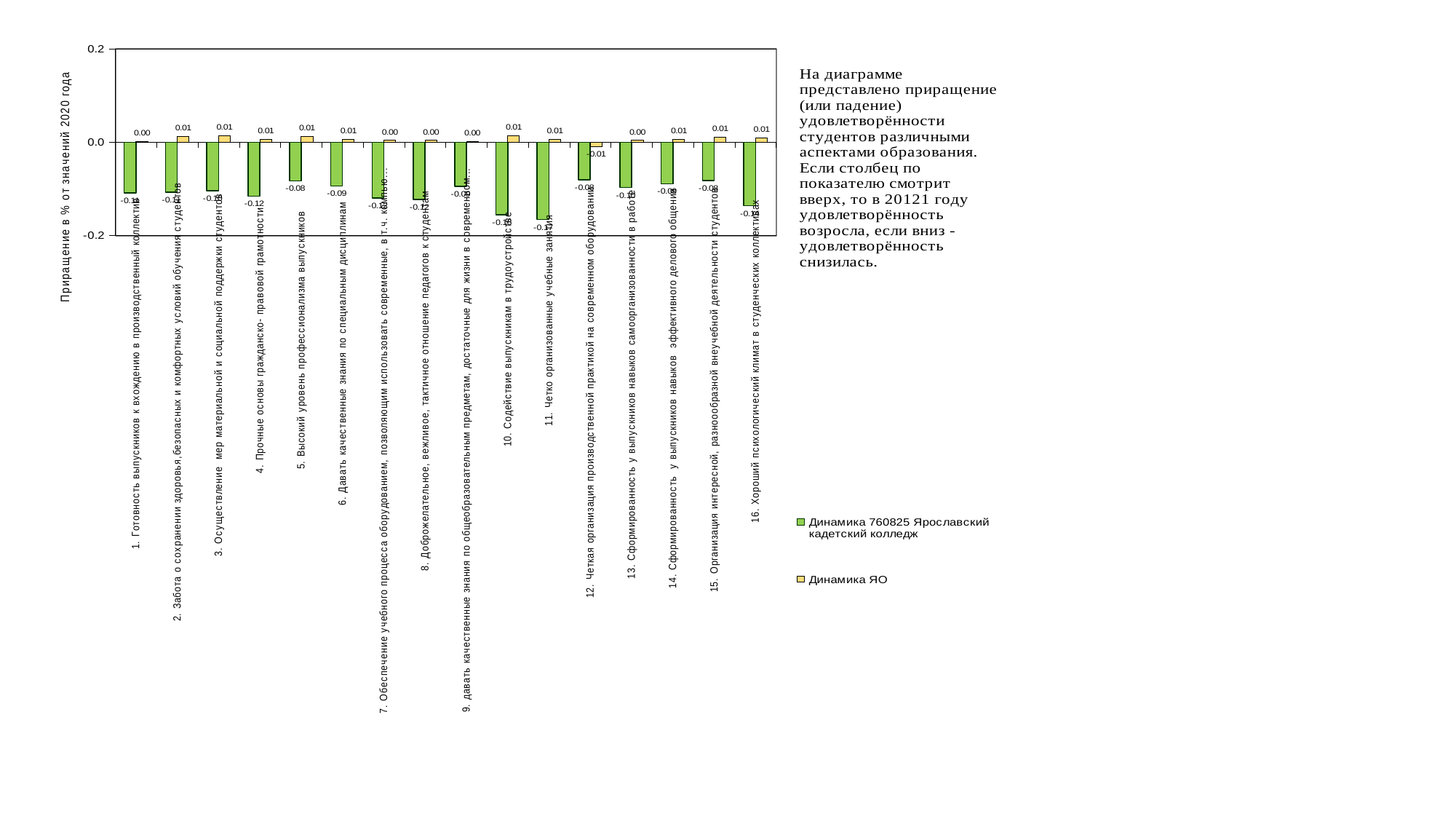
What is the value of the 'Динамика 760825 Ярославский кадетский колледж' series for category 5 (Высокий уровень профессионализма выпускников)? -0.08 What is the title of the vertical axis? Приращение в % от значений 2020 года What is the value of the 'Динамика ЯО' series for category 12 (Четкая организация производственной практикой на современном оборудовании)? -0.01 Which category has the lowest value for the 'Динамика ЯО' series? 12. Четкая организация производственной практикой на современном оборудовании What is the difference between the 'Динамика 760825 Ярославский кадетский колледж' values for category 5 and category 4? 0.04 What is the value of the 'Динамика 760825 Ярославский кадетский колледж' series for category 6 (Давать качественные знания по специальным дисциплинам)? -0.09 Which category has the lowest value for the 'Динамика 760825 Ярославский кадетский колледж' series? 11. Четко организованные учебные занятия How many categories are plotted along the x axis? 16 What is the value of the 'Динамика 760825 Ярославский кадетский колледж' series for category 4 (Прочные основы гражданско-правовой грамотности)? -0.12 For the 'Динамика 760825 Ярославский кадетский колледж' series, which is larger: the value for category 5 or the value for category 11? Category 5 How many series does the legend list? 2 What kind of chart is shown on the slide? Bar chart